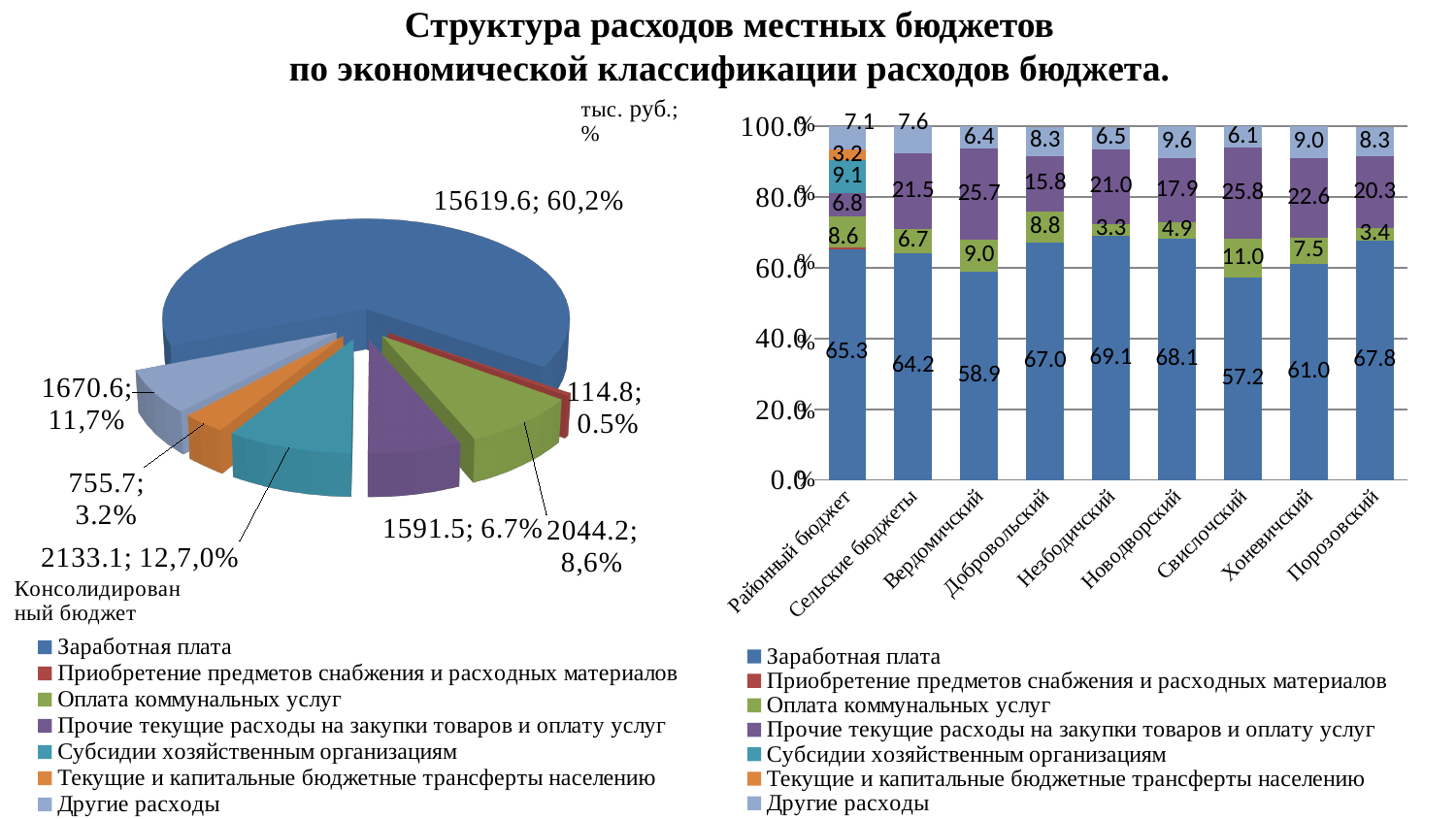
In the right chart, which category has the highest value for Заработная плата? Незбодичский What kind of chart is the left chart (Консолидированный бюджет)? pie chart In the right chart, how many series does the legend list? 7 In the right chart, what is the value of Другие расходы for Новодворский? 9.6 In the right chart, which category has the lowest value for Заработная плата? Свислочский In the right chart, what is the difference between the Заработная плата values for Районный бюджет and Сельские бюджеты? 1.1 In the right chart, what is the value of Заработная плата for Незбодичский? 69.1 In the left pie chart, what share does Заработная плата have? 60,2% What kind of chart is the right chart? bar chart In the right chart, how many budget categories are shown on the x axis? 9 In the left pie chart, which category has the smallest slice? Приобретение предметов снабжения и расходных материалов In the right chart, which is larger for Оплата коммунальных услуг: Свислочский or Хоневичский? Свислочский